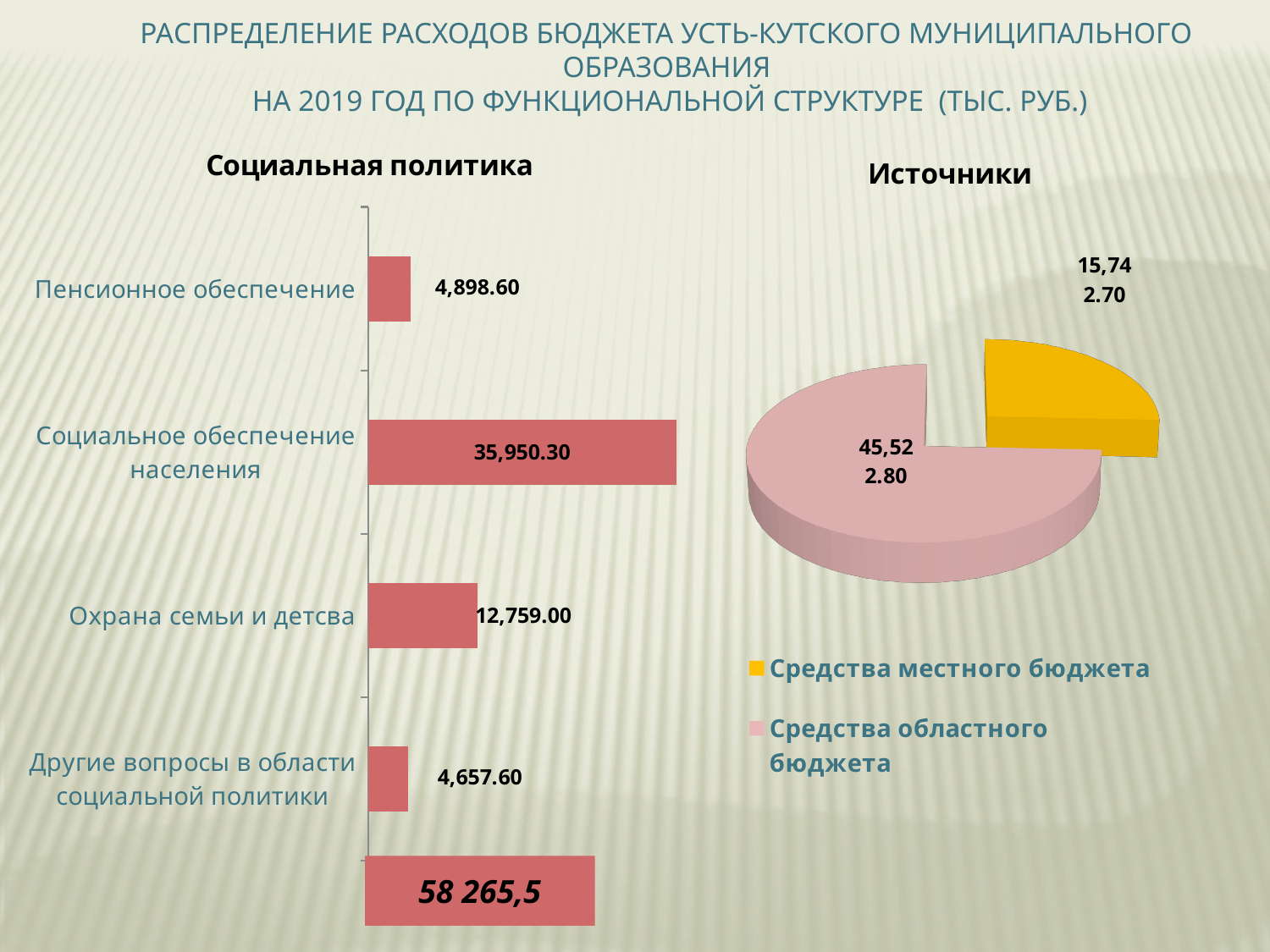
What kind of chart is the "Источники" chart on the right? pie chart In the "Источники" pie chart, which slice is larger: "Средства местного бюджета" or "Средства областного бюджета"? Средства областного бюджета In the "Социальная политика" chart, which is larger: "Пенсионное обеспечение" or "Другие вопросы в области социальной политики"? Пенсионное обеспечение In the "Социальная политика" chart, which category has the highest value? Социальное обеспечение населения What total value is shown in the box at the bottom of the "Социальная политика" chart? 58 265,5 In the "Социальная политика" chart, what is the value for "Охрана семьи и детсва"? 12,759.00 In the "Социальная политика" chart, what is the value for "Социальное обеспечение населения"? 35,950.30 How many entries does the legend of the "Источники" pie chart list? 2 In the "Социальная политика" chart, which category has the lowest value? Другие вопросы в области социальной политики What kind of chart is the "Социальная политика" chart on the left? bar chart How many categories are shown in the "Социальная политика" bar chart? 4 In the "Социальная политика" chart, what is the difference between "Социальное обеспечение населения" and "Охрана семьи и детсва"? 23,191.30